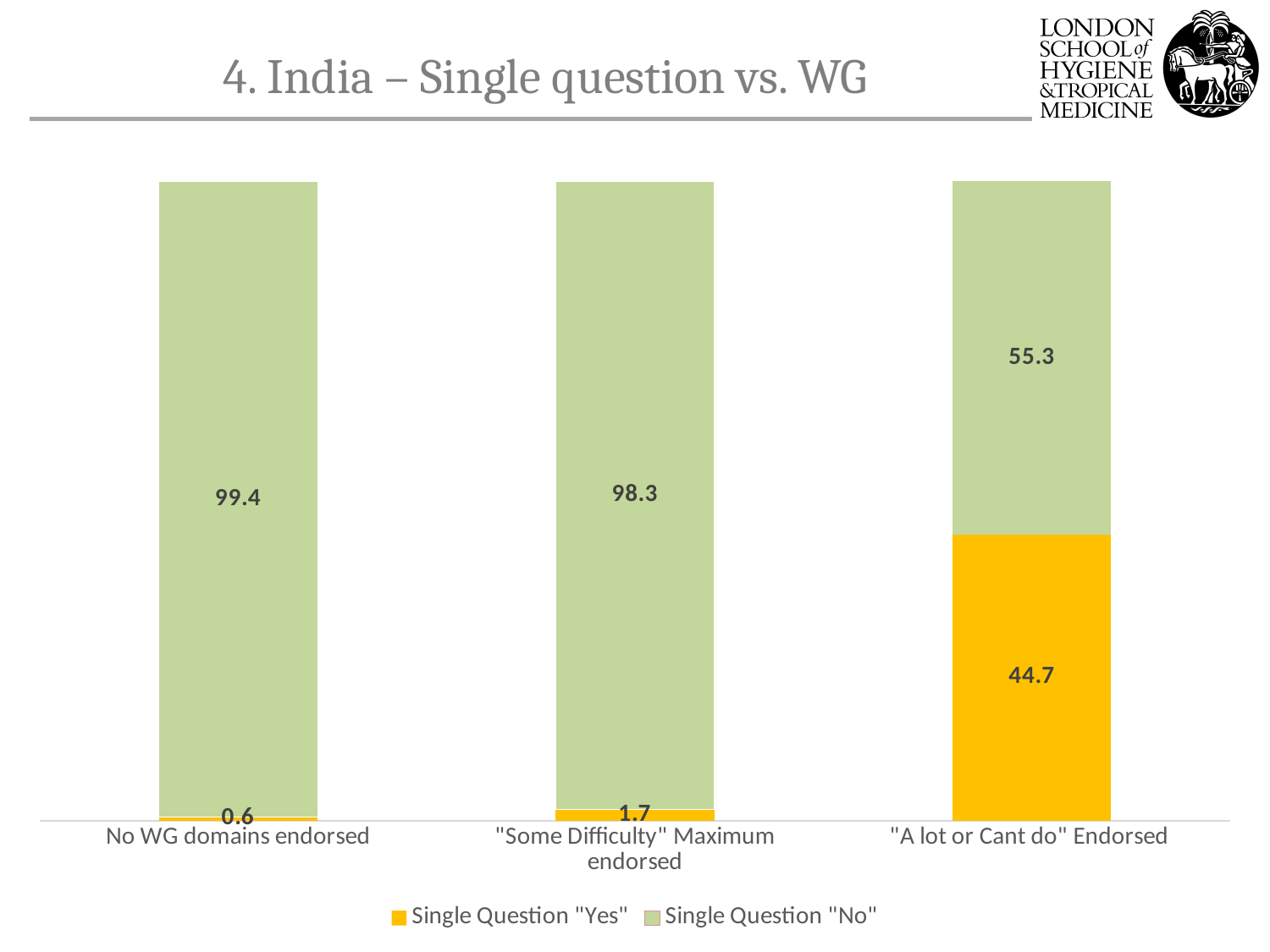
What is the difference between the Single Question "No" and Single Question "Yes" values for "A lot or Cant do" Endorsed? 10.6 Which category has the highest Single Question "Yes" value? "A lot or Cant do" Endorsed Which category has the lowest Single Question "Yes" value? No WG domains endorsed What is the Single Question "Yes" value for "A lot or Cant do" Endorsed? 44.7 How many categories are shown on the x axis? 3 What colour represents Single Question "Yes" in the chart? Orange/yellow Which is larger for "Some Difficulty" Maximum endorsed: Single Question "Yes" or Single Question "No"? Single Question "No" What kind of chart is shown on the slide? Stacked bar chart What is the Single Question "Yes" value for "Some Difficulty" Maximum endorsed? 1.7 How many series does the legend list? 2 What is the Single Question "No" value for "No WG domains endorsed"? 99.4 What is the Single Question "No" value for "A lot or Cant do" Endorsed? 55.3